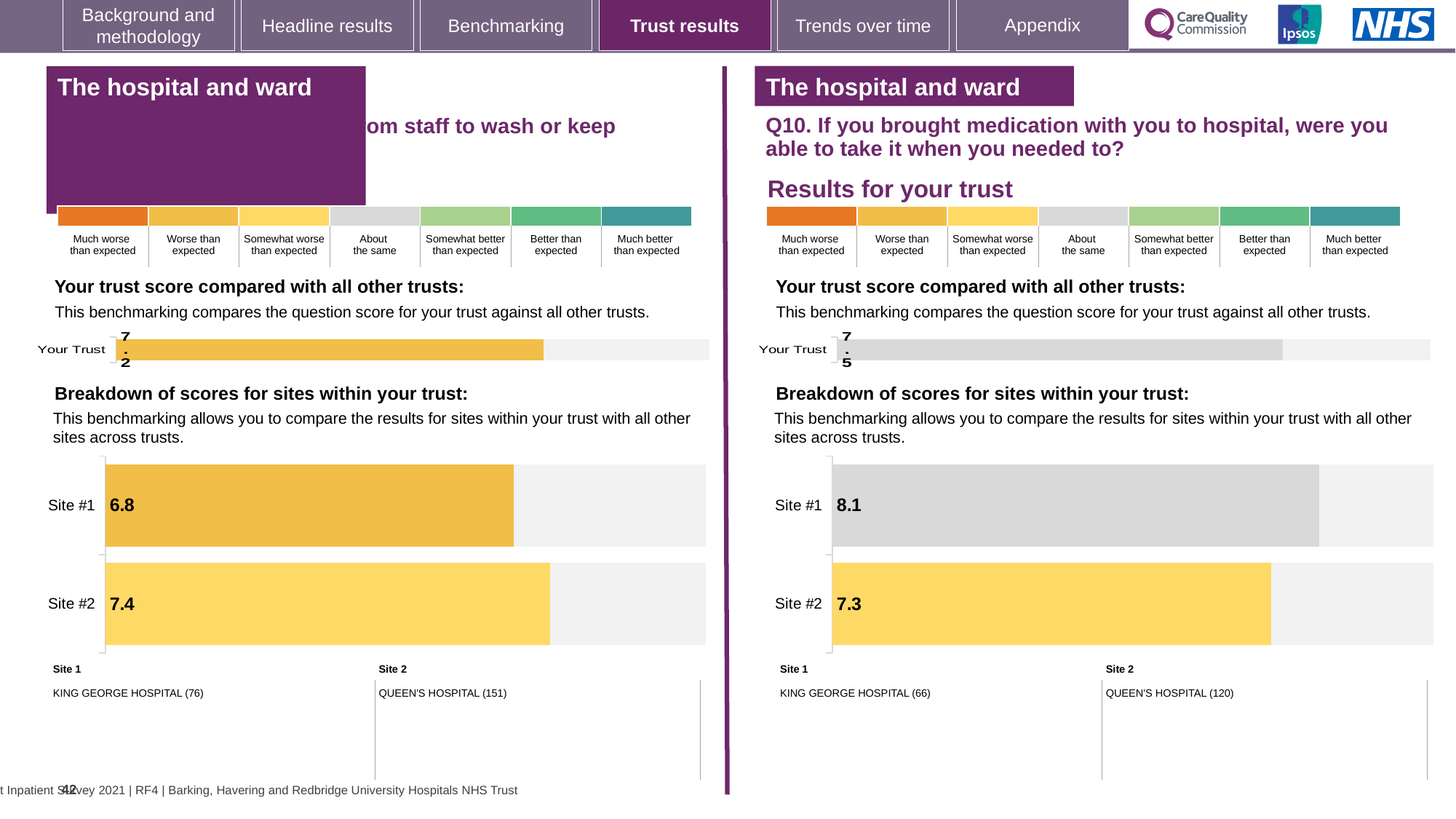
On the left-hand side of the slide, which site has the lower score in the breakdown of scores for sites within your trust? Site #1 On the right-hand side of the slide (Q10, medication), which site has the higher score in the breakdown of scores for sites within your trust? Site #1 On the left-hand side of the slide, what is the score for Site #1 in the breakdown of scores for sites within your trust? 6.8 On the right-hand side of the slide (Q10, medication), what is the score for Site #2 in the breakdown of scores for sites within your trust? 7.3 On the left-hand side of the slide, what is the 'Your Trust' score in the chart comparing your trust with all other trusts? 7.2 On the right-hand side of the slide (Q10, medication), what is the 'Your Trust' score in the chart comparing your trust with all other trusts? 7.5 What type of chart is used for the breakdown of scores for sites within your trust on the left-hand side of the slide? Bar chart On the right-hand side of the slide (Q10, medication), what is the score for Site #1 in the breakdown of scores for sites within your trust? 8.1 On the right-hand side of the slide (Q10, medication), what is the difference between the Site #1 and Site #2 scores in the site breakdown chart? 0.8 On the left-hand side of the slide, what is the difference between the Site #2 and Site #1 scores in the site breakdown chart? 0.6 On the left-hand side of the slide, what is the score for Site #2 in the breakdown of scores for sites within your trust? 7.4 How many sites are shown in the breakdown of scores chart on the right-hand side of the slide (Q10, medication)? 2